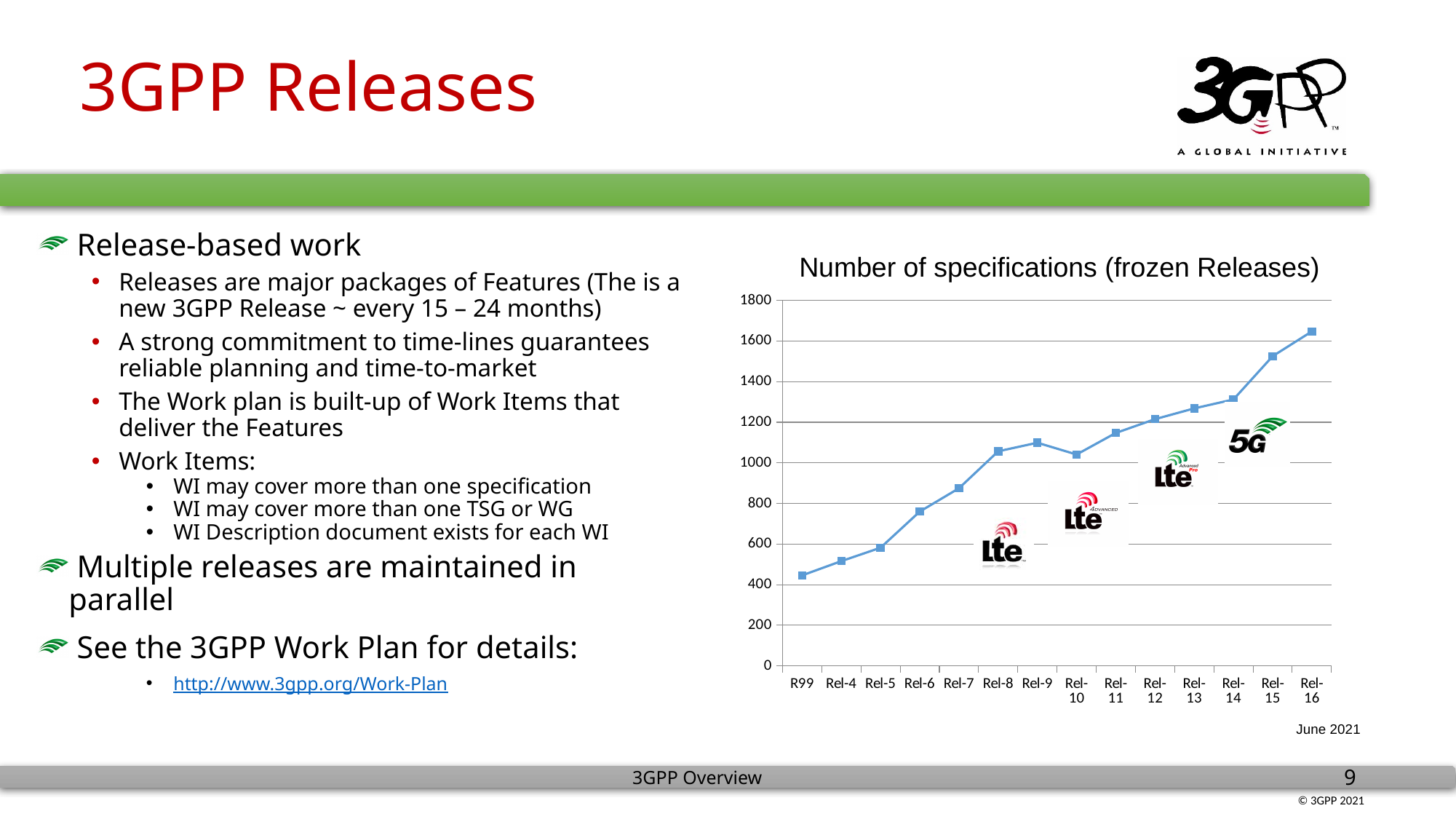
Is the value for Rel-15 greater or less than 1400? greater Is the value for Rel-16 greater or less than 1400? greater Which release has the highest number of specifications in the chart? Rel-16 How many releases are plotted along the x axis of the chart? 14 Overall, do the values rise or fall from R99 to Rel-16? rise Is the value for Rel-10 greater or less than 1200? less Which has the larger value, Rel-9 or Rel-10? Rel-9 Which has the larger value, Rel-14 or Rel-15? Rel-15 What kind of chart is shown on the slide? line chart What is the title of the chart? Number of specifications (frozen Releases) Which release has the lowest number of specifications in the chart? R99